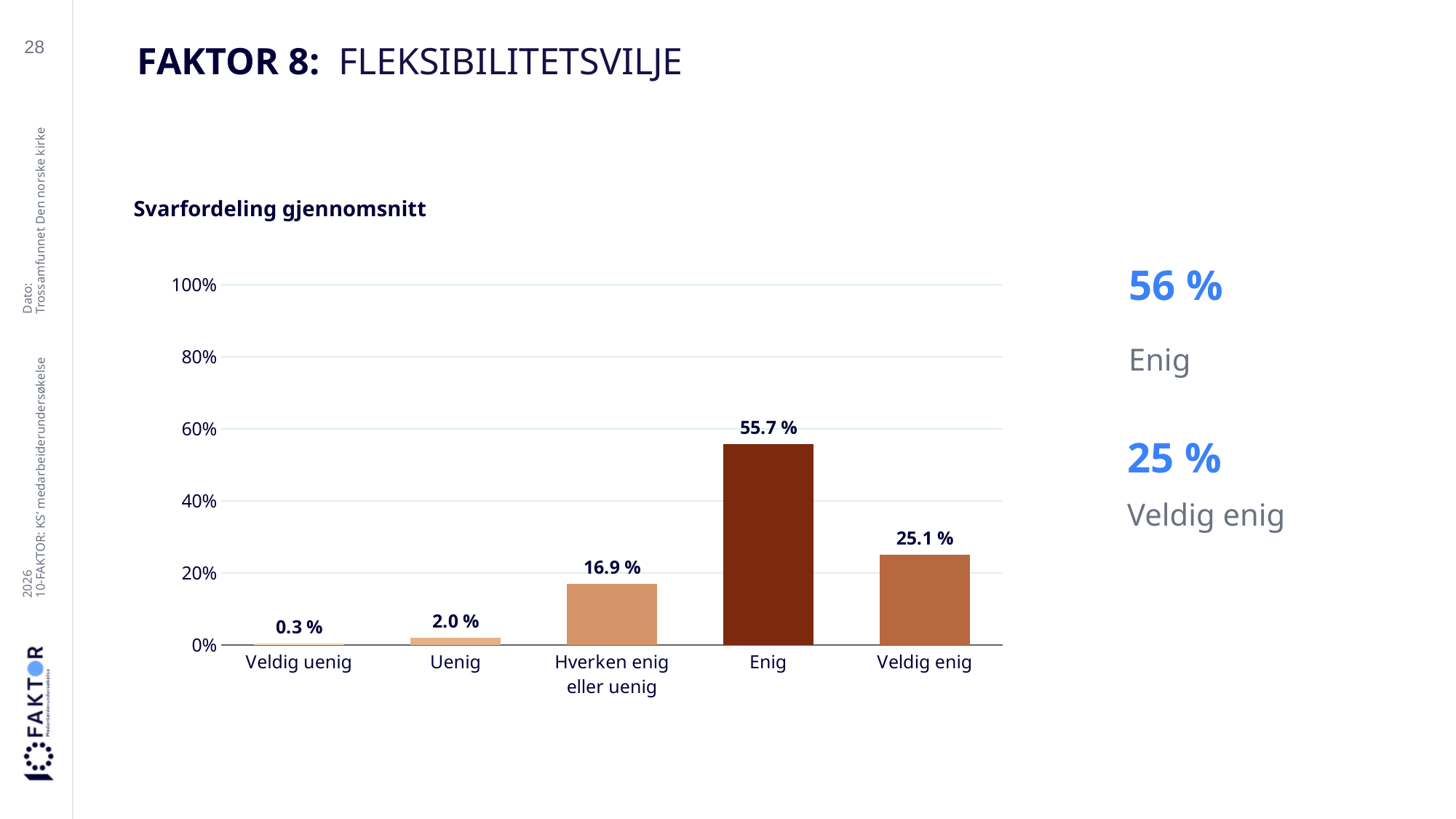
What is the value for Veldig enig? 25.1 % What is the value for Hverken enig eller uenig? 16.9 % Is the value for Enig greater or less than 40%? greater What is the value for Enig? 55.7 % Which category has the highest value? Enig What kind of chart is shown on the slide? bar chart Which is larger, the value for Uenig or the value for Hverken enig eller uenig? Hverken enig eller uenig What is the value for Veldig uenig? 0.3 % What is the title of the chart? Svarfordeling gjennomsnitt Which category has the lowest value? Veldig uenig How many categories are shown on the x axis? 5 What is the difference between the values for Enig and Veldig enig? 30.6 %